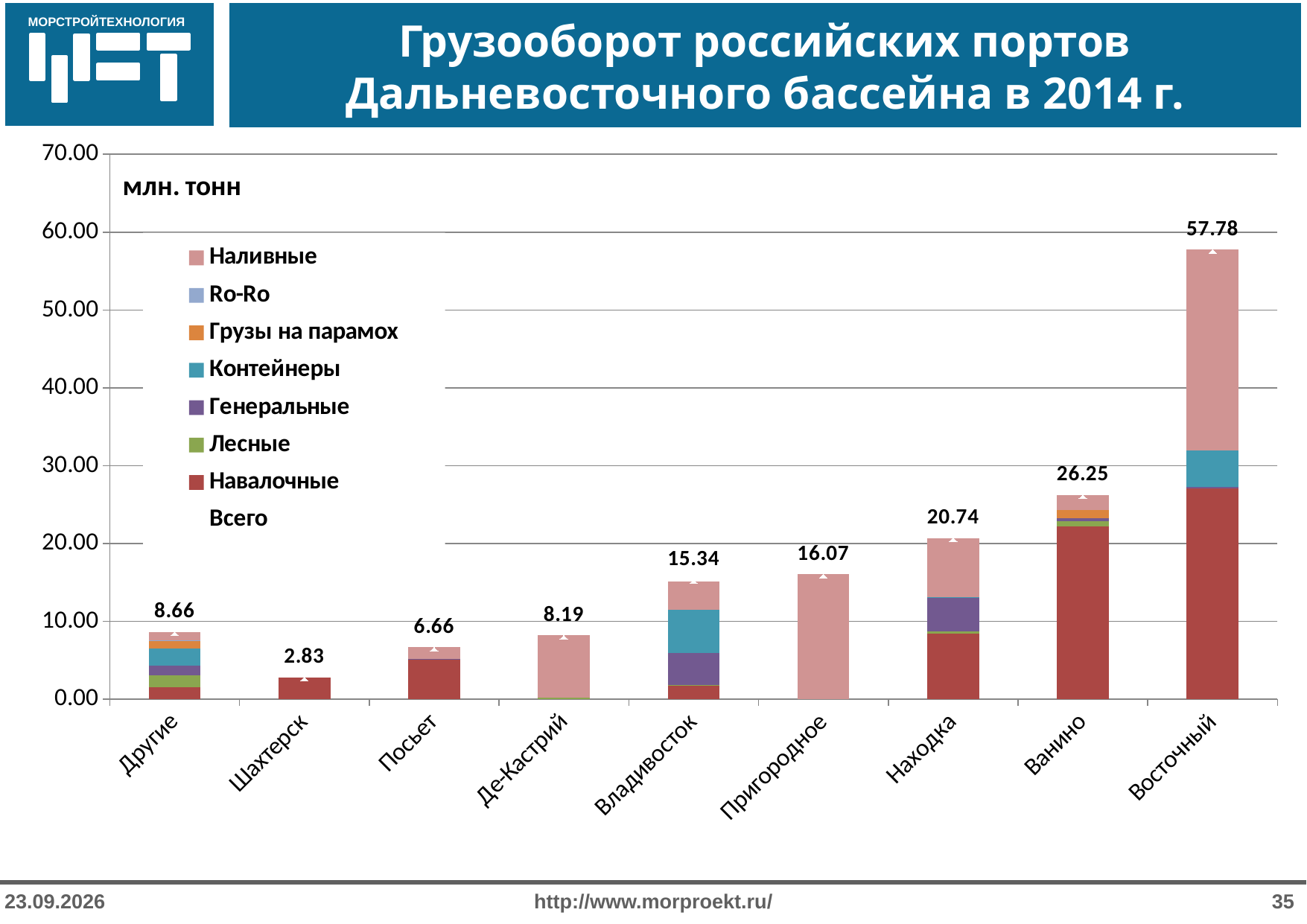
What is the difference between the totals for Восточный and Ванино? 31.53 What is the total cargo turnover shown for Восточный? 57.78 Which port has the lowest total cargo turnover? Шахтерск How many ports (categories) are shown on the x axis? 9 Is the Навалочные segment for Восточный greater or less than 20.00? greater What unit of measurement is written in the top-left corner of the chart area? млн. тонн Which has a larger total, Пригородное or Владивосток? Пригородное What kind of chart is shown on the slide? stacked bar chart Which port has the highest total cargo turnover? Восточный What is the difference between the totals for Находка and Владивосток? 5.40 Which has a larger total, Другие or Де-Кастрий? Другие What is the total value labelled above the bar for Ванино? 26.25